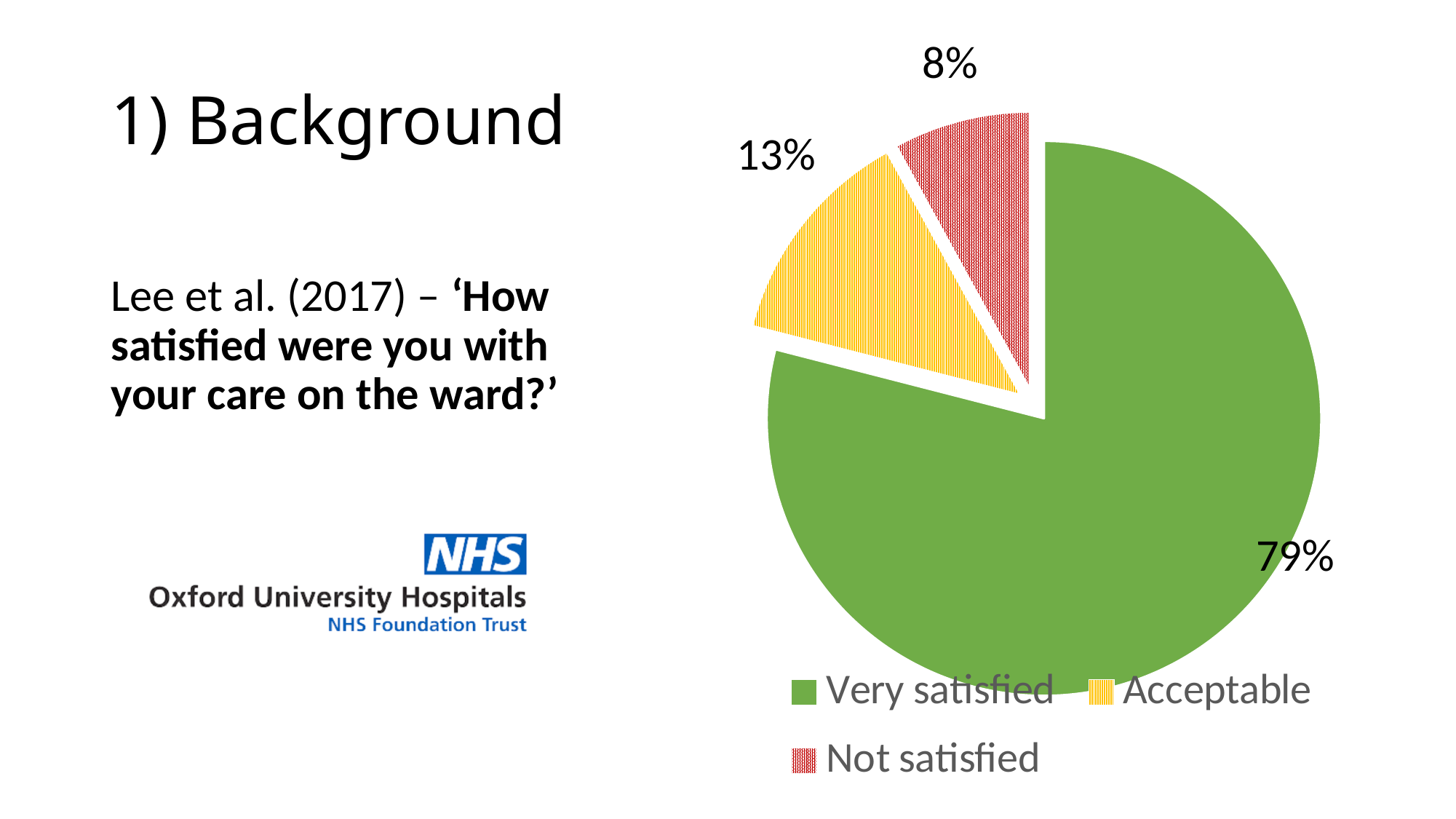
What colour is the Very satisfied slice? Green What is the difference in percentage points between Very satisfied and Acceptable? 66 Which is larger, the Acceptable share or the Not satisfied share? Acceptable Which category has the smallest share of the pie? Not satisfied Which category has the largest share of the pie? Very satisfied What is the difference in percentage points between Acceptable and Not satisfied? 5 What kind of chart is shown on the slide? Pie chart What percentage of respondents were Not satisfied? 8% How many categories does the pie chart show? 3 What percentage of respondents rated their care as Acceptable? 13% What percentage of respondents were Very satisfied? 79% Which legend entry is shown with a red pattern? Not satisfied